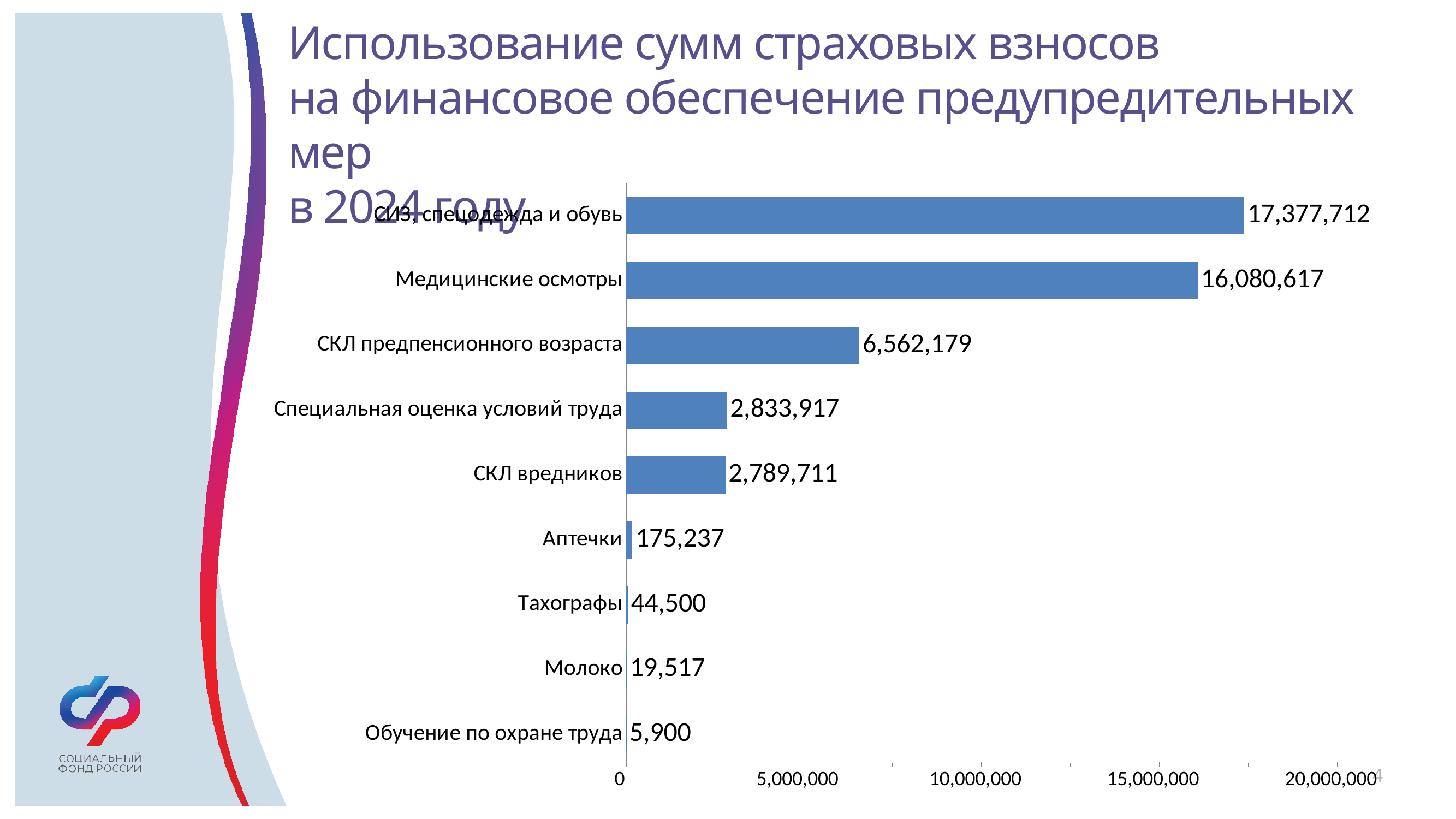
What is the value for Аптечки? 175,237 What is the difference between the values for Аптечки and Тахографы? 130,737 Which category has the highest value? СИЗ, спецодежда и обувь What is the value for Обучение по охране труда? 5,900 What kind of chart is shown on the slide? bar chart Which category has the lowest value? Обучение по охране труда How many categories are shown in the chart? 9 What is the value for Медицинские осмотры? 16,080,617 What is the value for СКЛ предпенсионного возраста? 6,562,179 What is the difference between the values for СИЗ, спецодежда и обувь and Медицинские осмотры? 1,297,095 Which is larger, the value for Специальная оценка условий труда or the value for СКЛ вредников? Специальная оценка условий труда Is the value for Медицинские осмотры greater or less than 15,000,000? greater